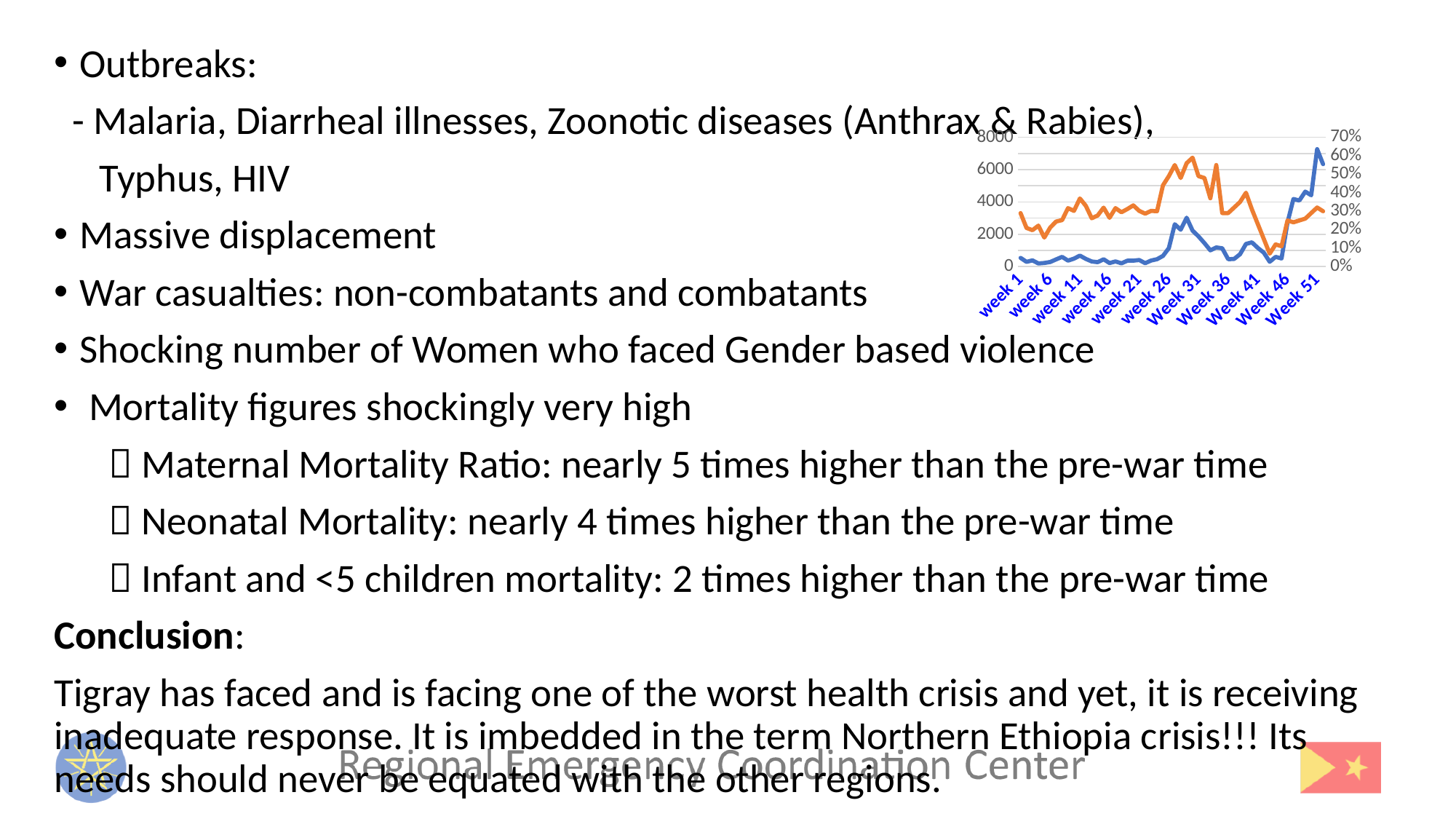
Does the blue line rise or fall between Week 46 and Week 51? rise At Week 51, which line is higher on the chart, the blue line or the orange line? blue How many lines are plotted on the chart? 2 How many week labels are shown along the x axis of the chart? 11 What is the highest value shown on the left vertical axis of the chart? 8000 What is the highest value shown on the right vertical axis of the chart? 70% What kind of chart is shown on the right side of the slide? line chart